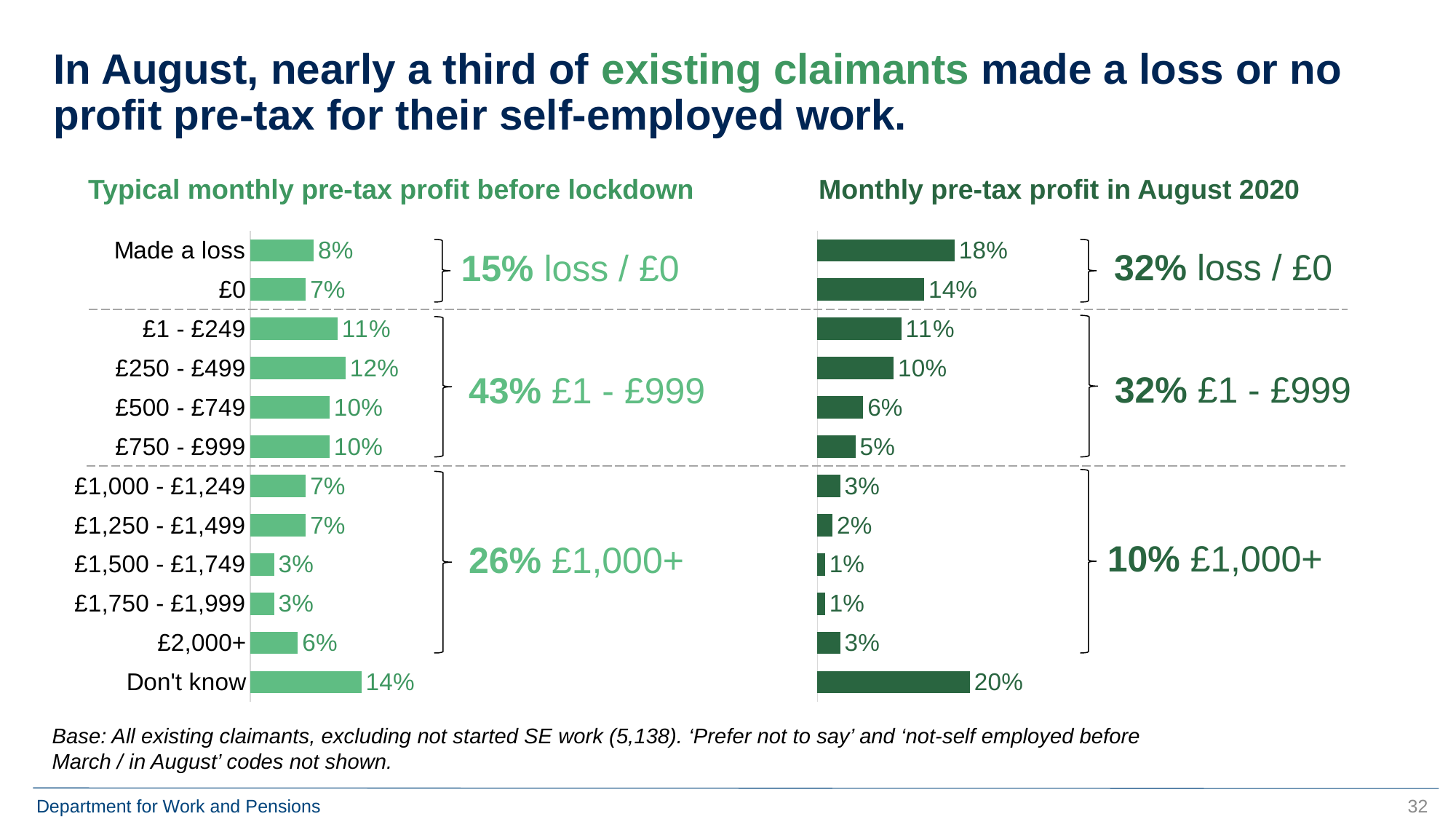
Which is larger: the value for '£2,000+' in the 'Typical monthly pre-tax profit before lockdown' chart or in the 'Monthly pre-tax profit in August 2020' chart? Typical monthly pre-tax profit before lockdown In the 'Typical monthly pre-tax profit before lockdown' chart, what is the value for 'Made a loss'? 8% In the 'Monthly pre-tax profit in August 2020' chart, what is the value for '£500 - £749'? 6% In the 'Monthly pre-tax profit in August 2020' chart, which category has the highest value? Don't know How many categories are shown in the 'Typical monthly pre-tax profit before lockdown' chart? 12 According to the annotation on the 'Monthly pre-tax profit in August 2020' chart, what share of claimants made a loss or £0? 32% In the 'Monthly pre-tax profit in August 2020' chart, which is larger: the value for '£1 - £249' or '£750 - £999'? £1 - £249 In the 'Typical monthly pre-tax profit before lockdown' chart, what is the difference between the values for '£250 - £499' and '£1,500 - £1,749'? 9% In the 'Monthly pre-tax profit in August 2020' chart, what is the difference between the values for 'Made a loss' and '£0'? 4% In the 'Monthly pre-tax profit in August 2020' chart, what is the value for 'Don't know'? 20% What type of chart is the 'Monthly pre-tax profit in August 2020' chart? Bar chart In the 'Typical monthly pre-tax profit before lockdown' chart, which category has the highest value? Don't know